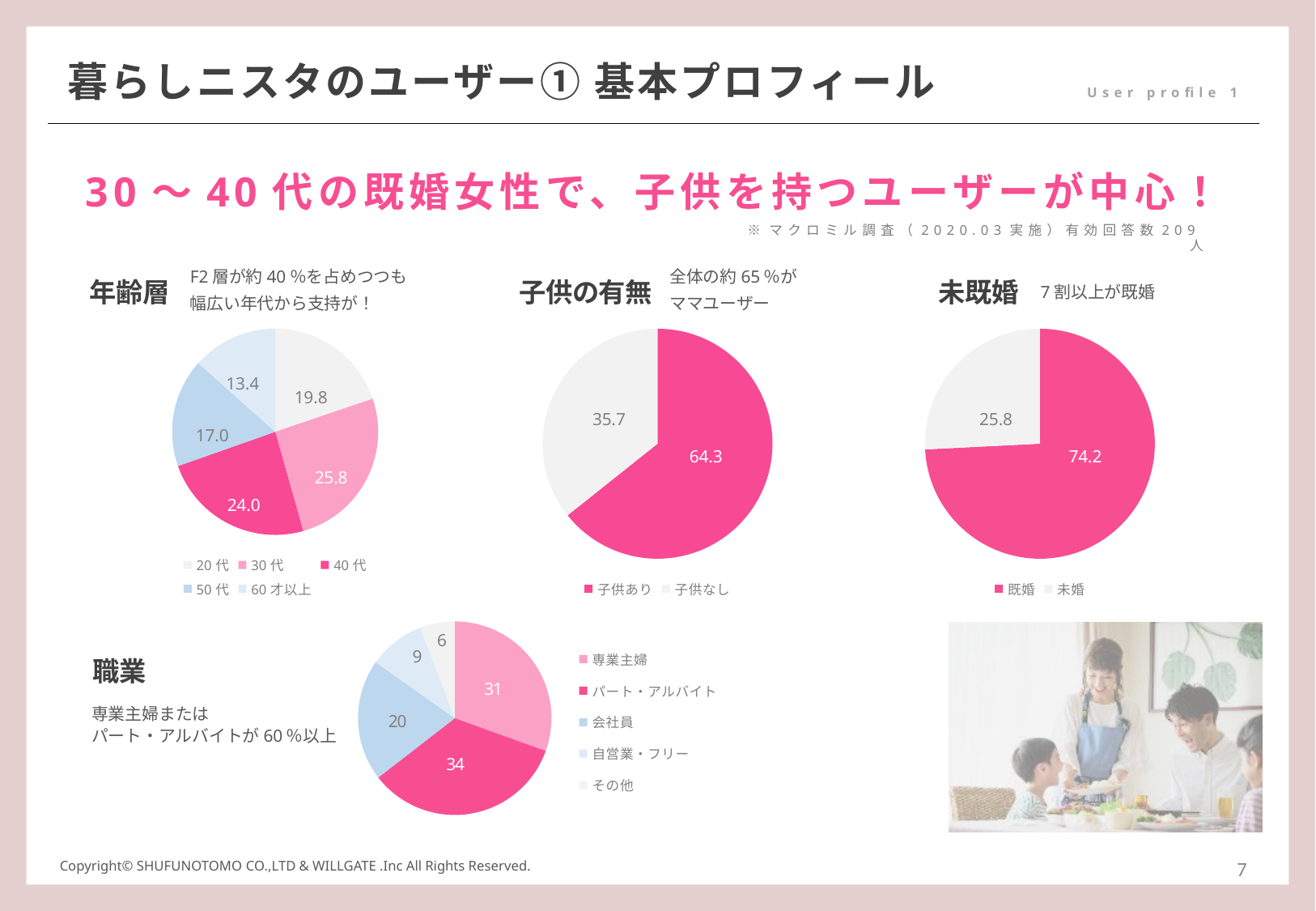
In the 子供の有無 (children) pie chart, what is the value for 子供あり? 64.3 In the 未既婚 (marital status) pie chart, what is the difference between 既婚 and 未婚? 48.4 In the 未既婚 (marital status) pie chart, what is the value for 未婚? 25.8 In the 子供の有無 (children) pie chart, which is larger, 子供あり or 子供なし? 子供あり In the 年齢層 (age group) pie chart, which age group has the smallest share? 60才以上 In the 年齢層 (age group) pie chart, what is the value for 30代? 25.8 In the 職業 (occupation) pie chart, what is the combined value of 専業主婦 and パート・アルバイト? 65 In the 職業 (occupation) pie chart, which category has the largest share? パート・アルバイト In the 年齢層 (age group) pie chart, how many categories does the legend list? 5 In the 職業 (occupation) pie chart, what is the value for 会社員? 20 What type of chart is used for the 未既婚 (marital status) data? Pie chart In the 年齢層 (age group) pie chart, what is the difference between the values for 30代 and 40代? 1.8